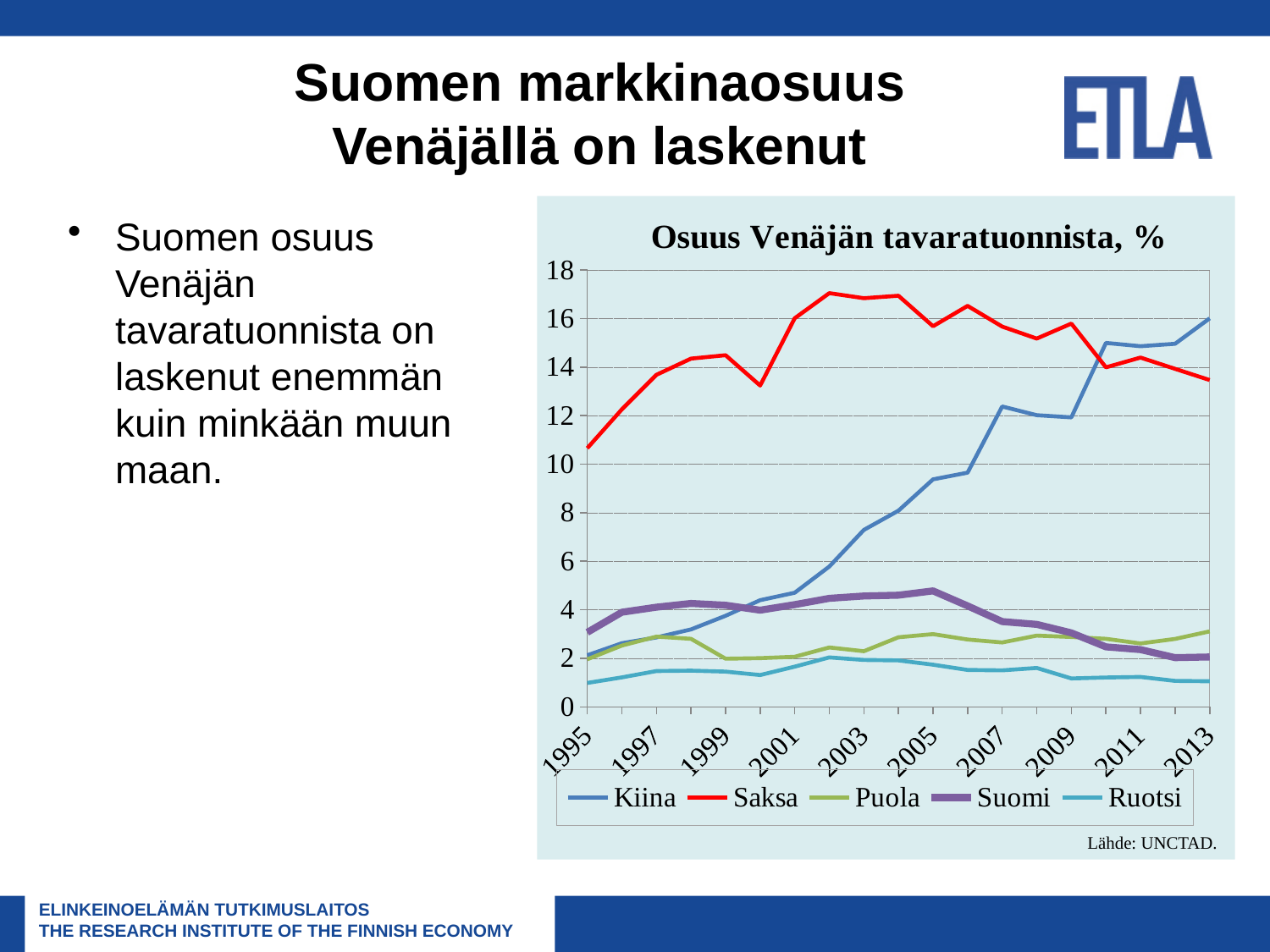
What kind of chart is shown on the slide? line chart Is the value for Kiina in 2013 greater or less than 14? greater Is the value for Saksa in 1995 greater or less than 10? greater In 2003, which is larger: the value for Saksa or the value for Kiina? Saksa How many series does the chart legend list? 5 Does the Kiina series generally rise or fall from 1995 to 2013? rise Which series has the lowest value in 2013? Ruotsi Which series has the highest value in 2013? Kiina What is the title of the chart? Osuus Venäjän tavaratuonnista, % Is the value for Suomi in 2013 greater or less than 4? less Which series has the highest value in 1995? Saksa Does the Suomi series rise or fall from 2005 to 2013? fall